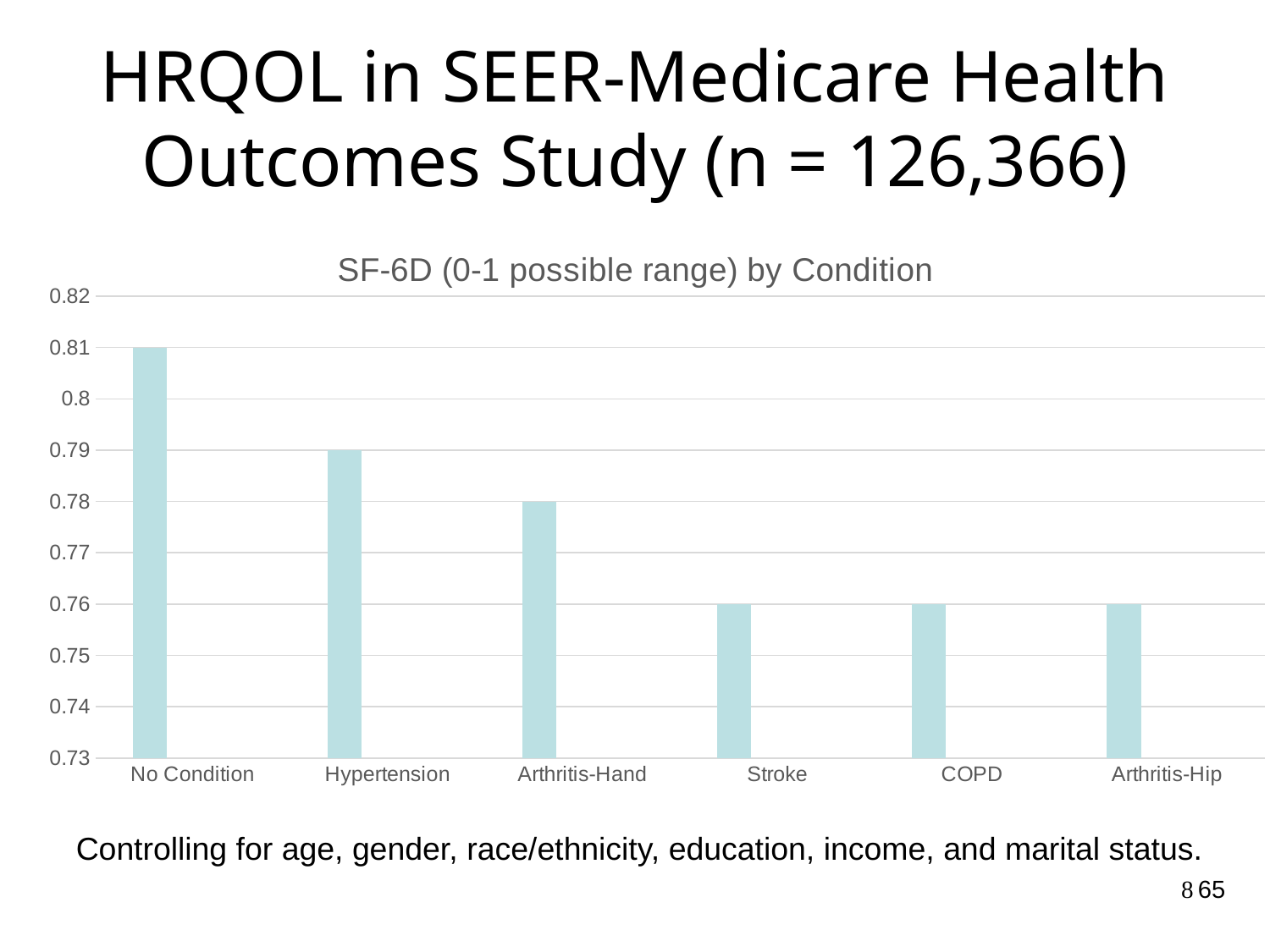
What is the difference between the SF-6D values for No Condition and COPD? 0.05 What is the SF-6D value for Stroke? 0.76 What is the difference between the SF-6D values for No Condition and Hypertension? 0.02 Which condition has the highest SF-6D value? No Condition What is the SF-6D value for No Condition? 0.81 What is the SF-6D value for Hypertension? 0.79 Is the SF-6D value for Arthritis-Hip greater or less than 0.78? less What kind of chart is shown on the slide? Bar chart What is the title of the chart? SF-6D (0-1 possible range) by Condition Which has a larger SF-6D value, Hypertension or Arthritis-Hand? Hypertension How many conditions are shown on the x axis? 6 What is the SF-6D value for Arthritis-Hand? 0.78